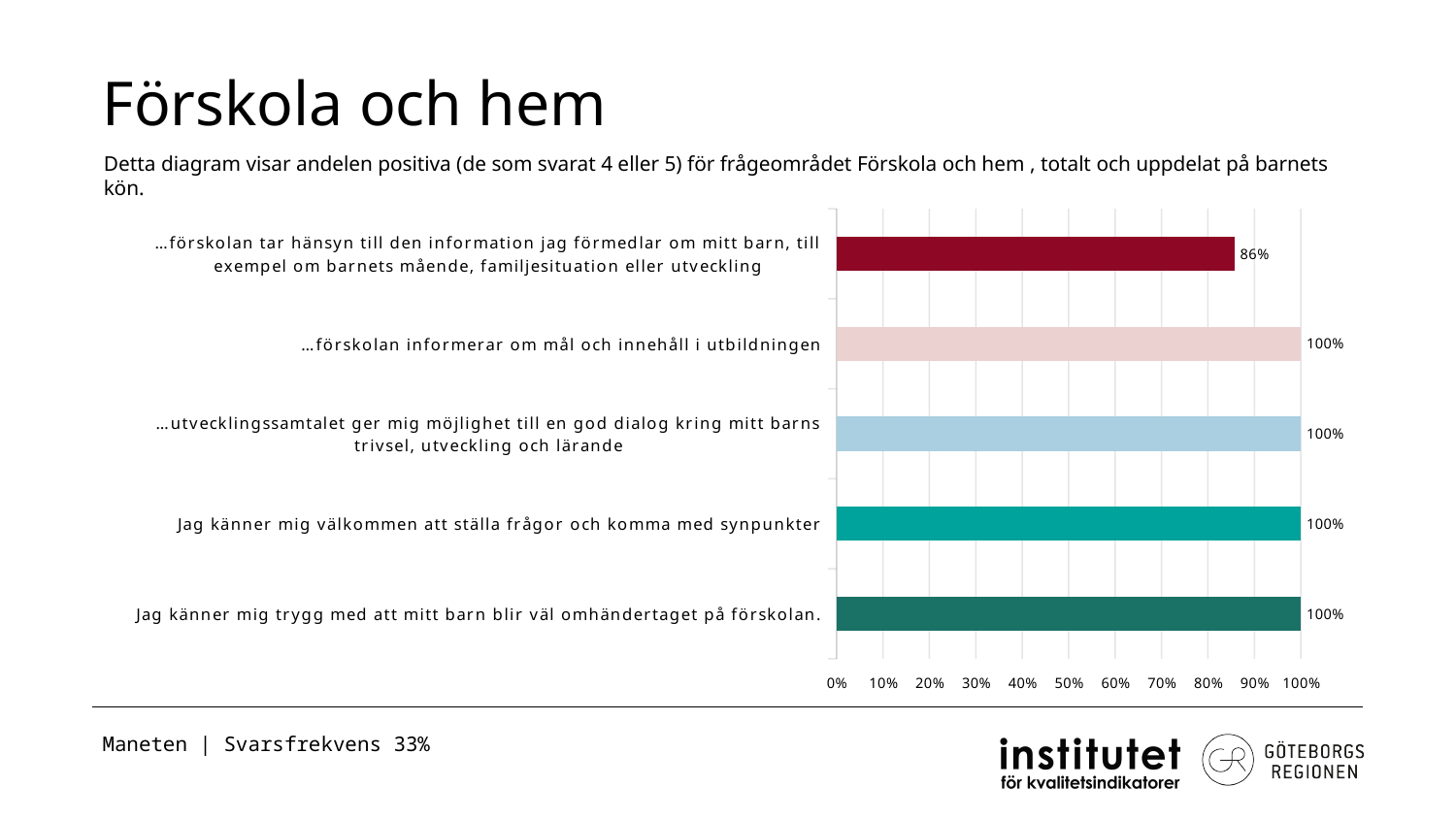
How many categories have a value of 100%? 4 What is the value for "Jag känner mig välkommen att ställa frågor och komma med synpunkter"? 100% What is the value for "Jag känner mig trygg med att mitt barn blir väl omhändertaget på förskolan."? 100% What is the title of the slide containing the chart? Förskola och hem Is the value for "…förskolan tar hänsyn till den information jag förmedlar om mitt barn, till exempel om barnets mående, familjesituation eller utveckling" greater or less than 80%? greater Which is larger: the value for "Jag känner mig välkommen att ställa frågor och komma med synpunkter" or the value for "…förskolan tar hänsyn till den information jag förmedlar om mitt barn, till exempel om barnets mående, familjesituation eller utveckling"? Jag känner mig välkommen att ställa frågor och komma med synpunkter What is the value for "…förskolan informerar om mål och innehåll i utbildningen"? 100% What is the value for "…förskolan tar hänsyn till den information jag förmedlar om mitt barn, till exempel om barnets mående, familjesituation eller utveckling"? 86% Which category has the lowest value? …förskolan tar hänsyn till den information jag förmedlar om mitt barn, till exempel om barnets mående, familjesituation eller utveckling What is the difference between the value for "…förskolan informerar om mål och innehåll i utbildningen" and the value for "…förskolan tar hänsyn till den information jag förmedlar om mitt barn, till exempel om barnets mående, familjesituation eller utveckling"? 14% How many categories are shown in the chart? 5 What kind of chart is shown on the slide? Bar chart